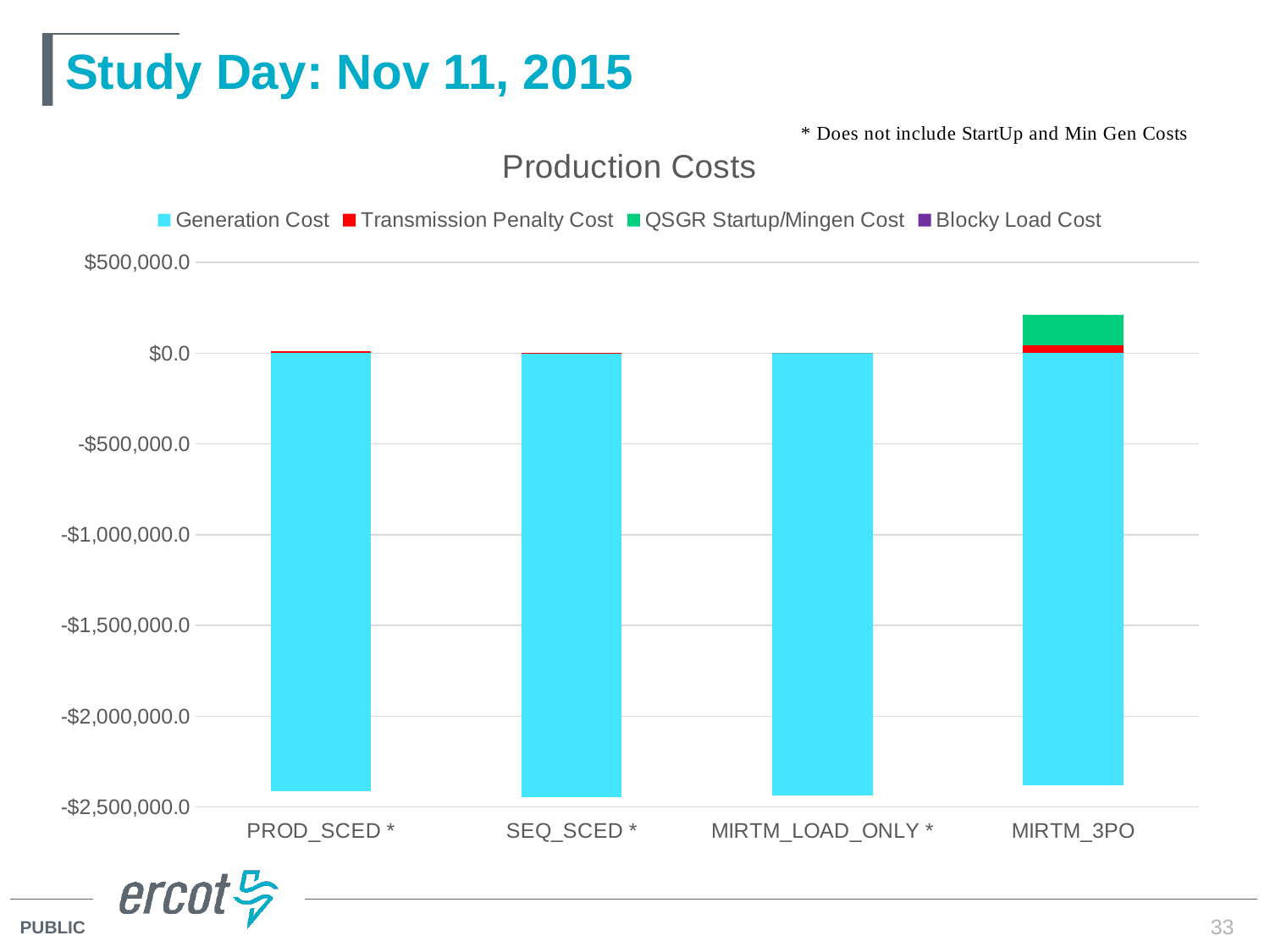
Is the Generation Cost value for MIRTM_3PO greater or less than -$2,000,000.0? less Is the QSGR Startup/Mingen Cost value for MIRTM_3PO greater or less than $0.0? greater What is the lowest value labelled on the chart's y axis? -$2,500,000.0 What kind of chart is shown on the slide? Stacked bar chart What is the title of the chart? Production Costs Which category has the largest Transmission Penalty Cost segment? MIRTM_3PO Which category has the largest QSGR Startup/Mingen Cost segment? MIRTM_3PO Is the QSGR Startup/Mingen Cost value for MIRTM_3PO greater or less than $500,000.0? less How many series does the chart's legend list? 4 How many categories are shown on the x axis of the chart? 4 Which series is shown in green in the chart's legend? QSGR Startup/Mingen Cost